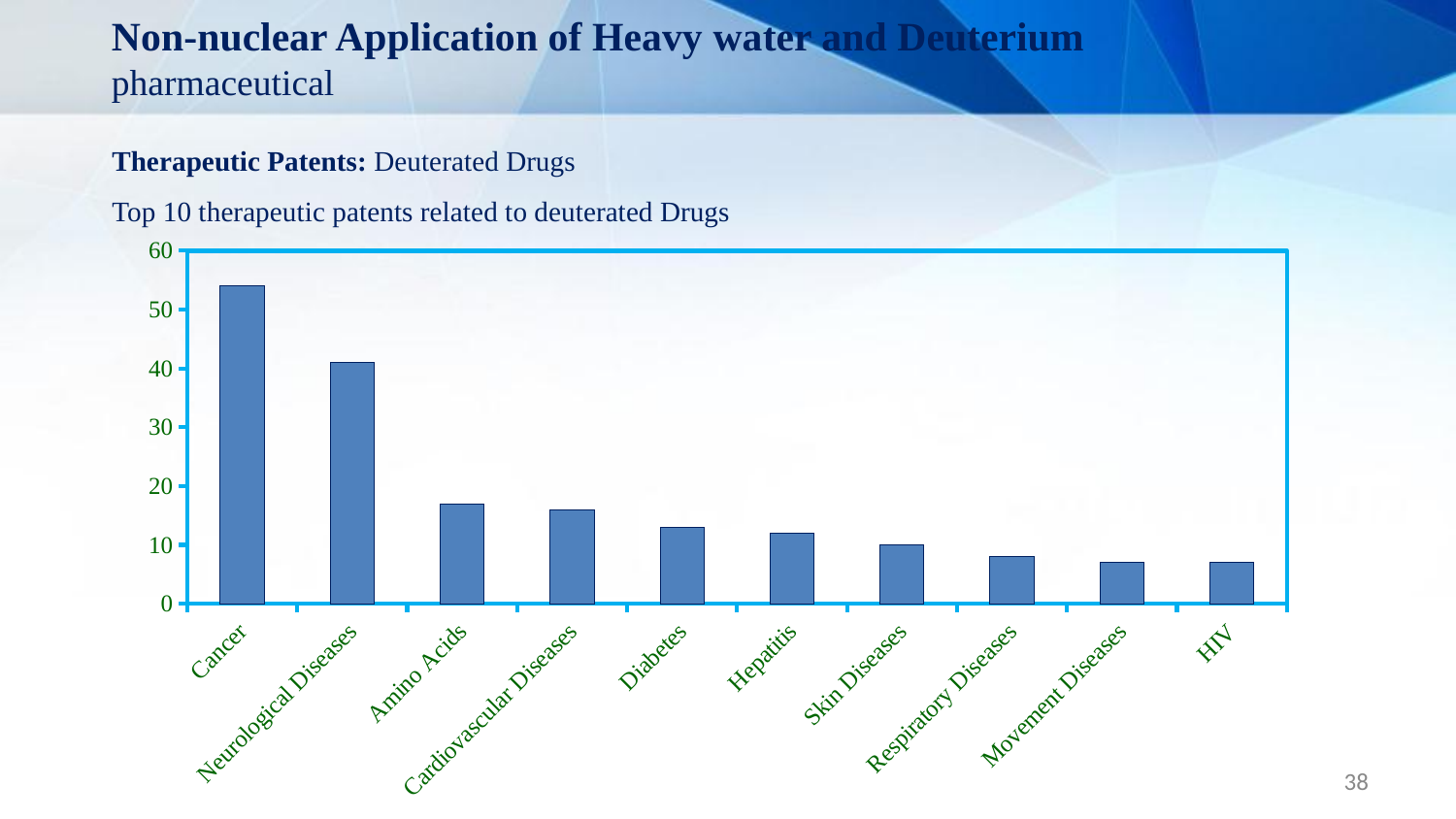
Is the value for Neurological Diseases greater or less than 30? greater Which category has the highest value in the chart? Cancer How many categories are shown on the x axis of the chart? 10 Is the value for Cancer greater or less than 50? greater What kind of chart is shown on the slide? bar chart What is the highest value shown on the y axis of the chart? 60 Do the values rise or fall moving from left to right along the x axis? fall Which has a larger value, Amino Acids or Diabetes? Amino Acids Is the value for Cardiovascular Diseases greater or less than 20? less Which has a larger value, Cancer or Neurological Diseases? Cancer